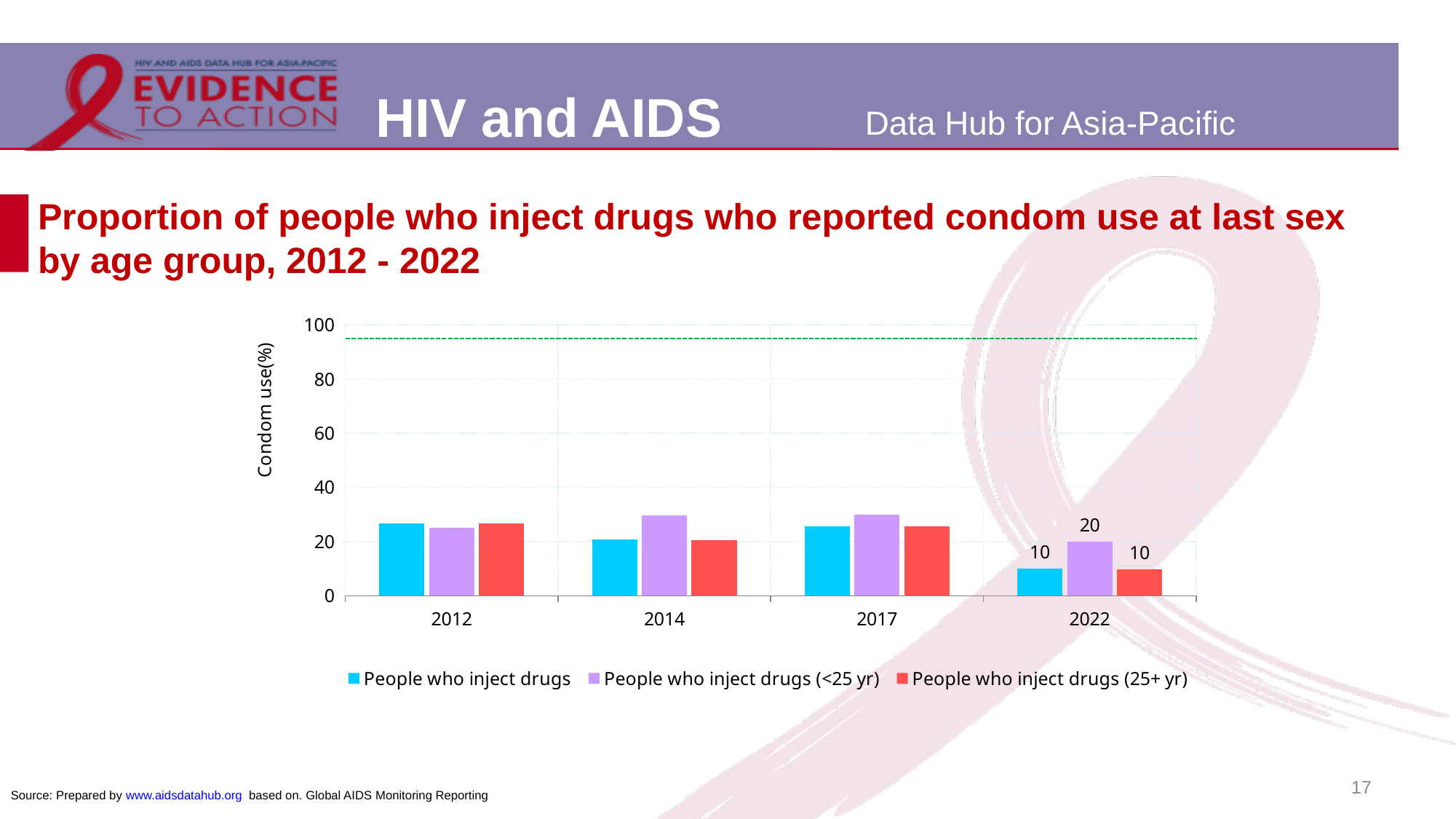
What is the value for People who inject drugs (25+ yr) in 2022? 10 In 2022, which is larger: the value for People who inject drugs (<25 yr) or the value for People who inject drugs (25+ yr)? People who inject drugs (<25 yr) In 2022, which series has the highest value? People who inject drugs (<25 yr) What is the label of the y axis? Condom use(%) What kind of chart is shown on the slide? Bar chart How many series does the legend list? 3 What is the value for People who inject drugs in 2022? 10 In 2022, what is the difference between the value for People who inject drugs (<25 yr) and the value for People who inject drugs? 10 Is the value for People who inject drugs in 2012 greater or less than 20? greater What is the value for People who inject drugs (<25 yr) in 2022? 20 How many years are shown on the x axis? 4 Is the value for People who inject drugs (<25 yr) in 2014 greater or less than 40? less